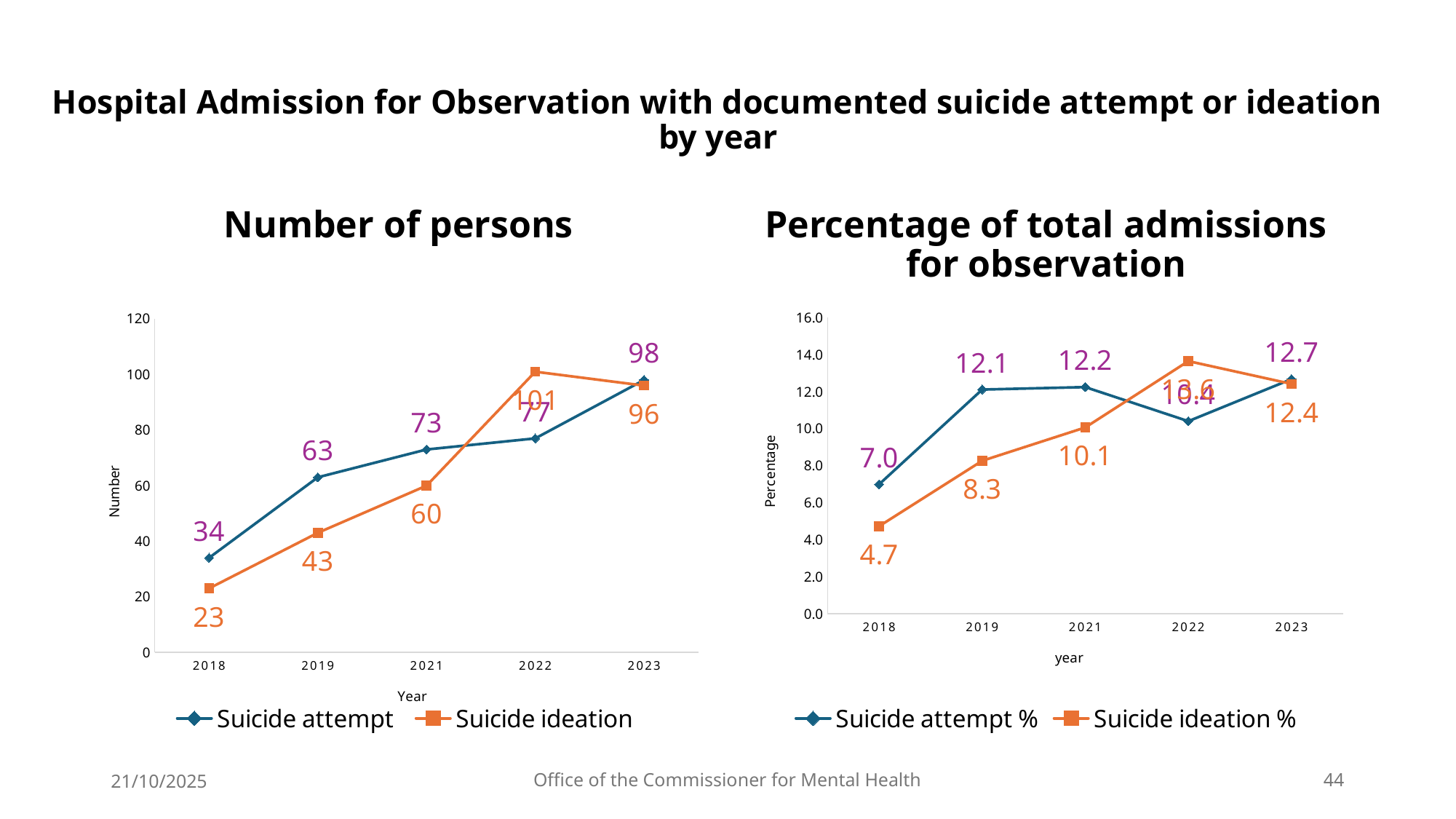
In the 'Percentage of total admissions for observation' chart, what is the difference between Suicide attempt % and Suicide ideation % in 2021? 2.1 In the 'Number of persons' chart, in which year is Suicide ideation highest? 2022 In the 'Number of persons' chart, what is the value for Suicide ideation in 2021? 60 In the 'Number of persons' chart, what is the value for Suicide attempt in 2018? 34 In the 'Percentage of total admissions for observation' chart, what is the value for Suicide ideation % in 2018? 4.7 In the 'Percentage of total admissions for observation' chart, what is the value for Suicide attempt % in 2023? 12.7 In the 'Number of persons' chart, which series has the larger value in 2023, Suicide attempt or Suicide ideation? Suicide attempt What type of chart is the 'Number of persons' chart? Line chart In the 'Number of persons' chart, what is the difference between Suicide attempt and Suicide ideation in 2019? 20 In the 'Number of persons' chart, in which year is Suicide attempt lowest? 2018 In the 'Number of persons' chart, how many years are shown on the x axis? 5 In the 'Percentage of total admissions for observation' chart, how many series does the legend list? 2